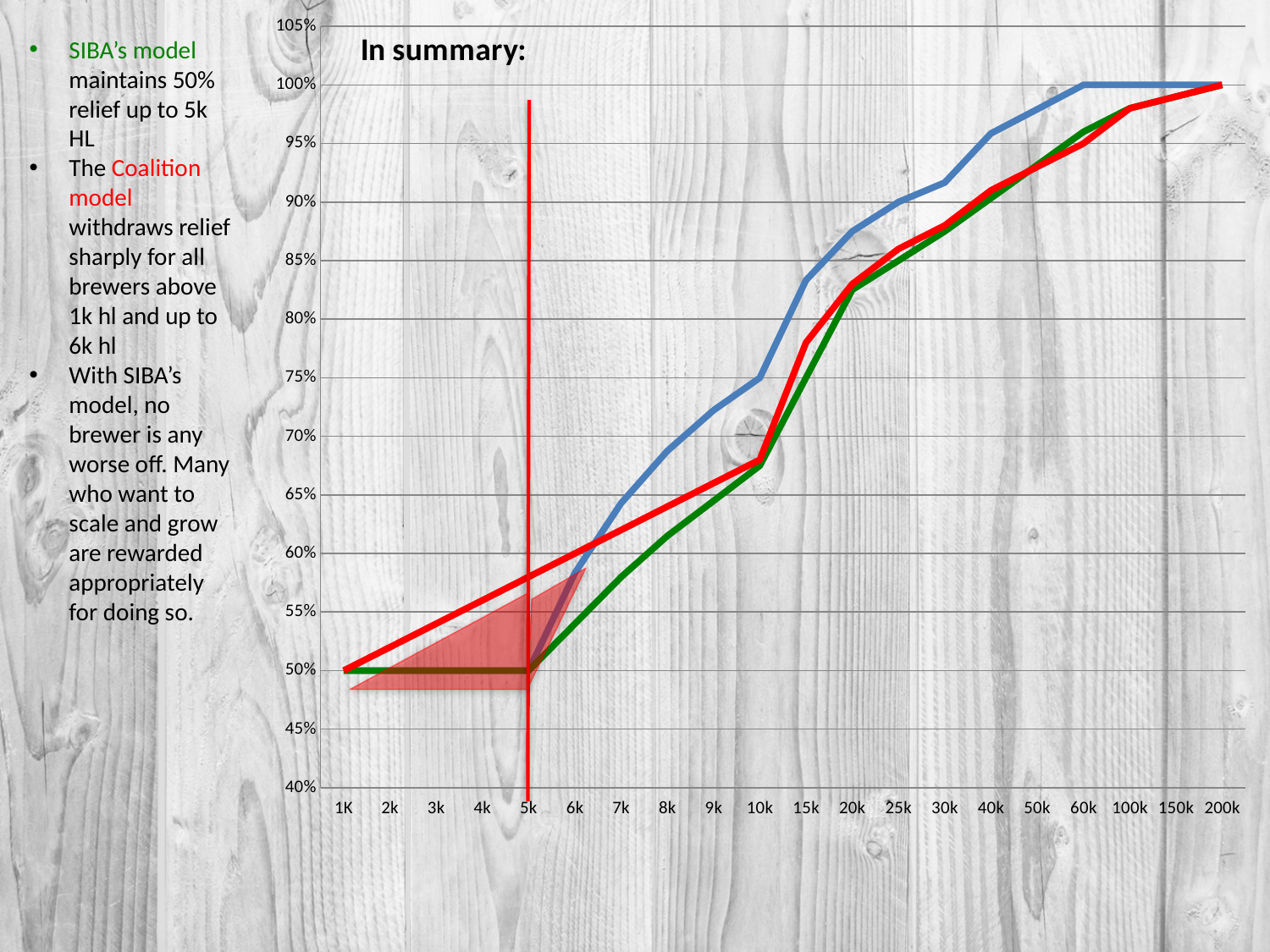
Is the value of the green line at 10k greater or less than 70%? less What is the value of the green line at 3k? 50% At 3k, which line has the higher value, the red line or the green line? red line What kind of chart is shown on the slide? line chart How many categories are shown on the x axis of the chart? 20 What value do all three lines reach at 200k? 100% What is the value of the red line at 1K? 50% At 7k, which line has the higher value, the blue line or the green line? blue line Do the values of the lines generally rise or fall as you move from 1K to 200k along the x axis? rise Is the value of the blue line at 10k greater or less than 70%? greater What is the difference between the green line's value at 200k and its value at 3k? 50% Is the value of the red line at 5k greater or less than 55%? greater